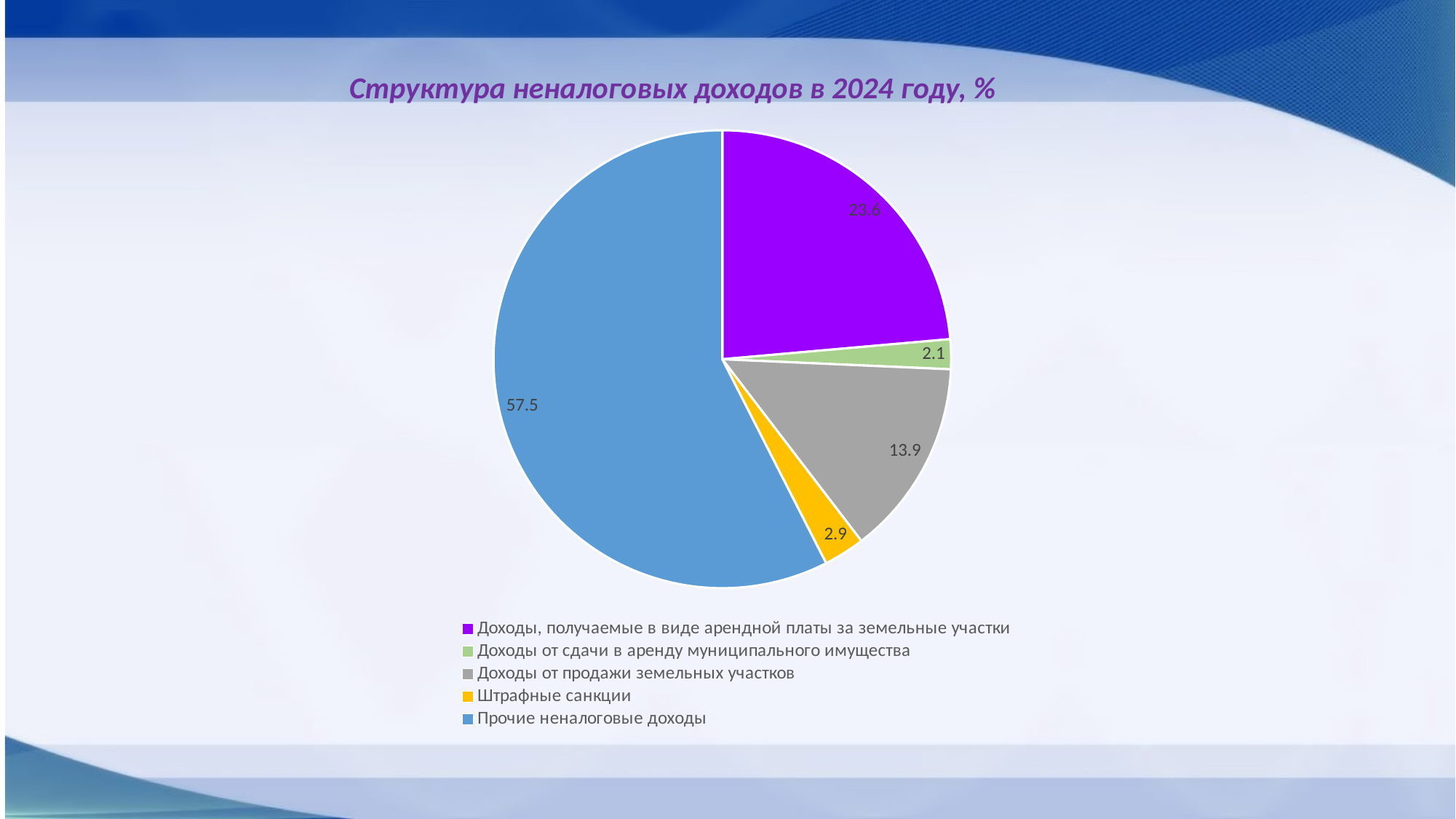
What is the title of the chart? Структура неналоговых доходов в 2024 году, % What is the value for Доходы от сдачи в аренду муниципального имущества? 2.1 Which category has the largest share of the pie? Прочие неналоговые доходы What is the value for Доходы, получаемые в виде арендной платы за земельные участки? 23.6 Which category has the smallest share of the pie? Доходы от сдачи в аренду муниципального имущества Which is larger: Штрафные санкции or Доходы от сдачи в аренду муниципального имущества? Штрафные санкции What is the difference between the values for Доходы, получаемые в виде арендной платы за земельные участки and Доходы от продажи земельных участков? 9.7 What is the value for Прочие неналоговые доходы? 57.5 What is the value for Доходы от продажи земельных участков? 13.9 What is the value for Штрафные санкции? 2.9 How many slices does the pie chart have? 5 What type of chart is shown on the slide? pie chart